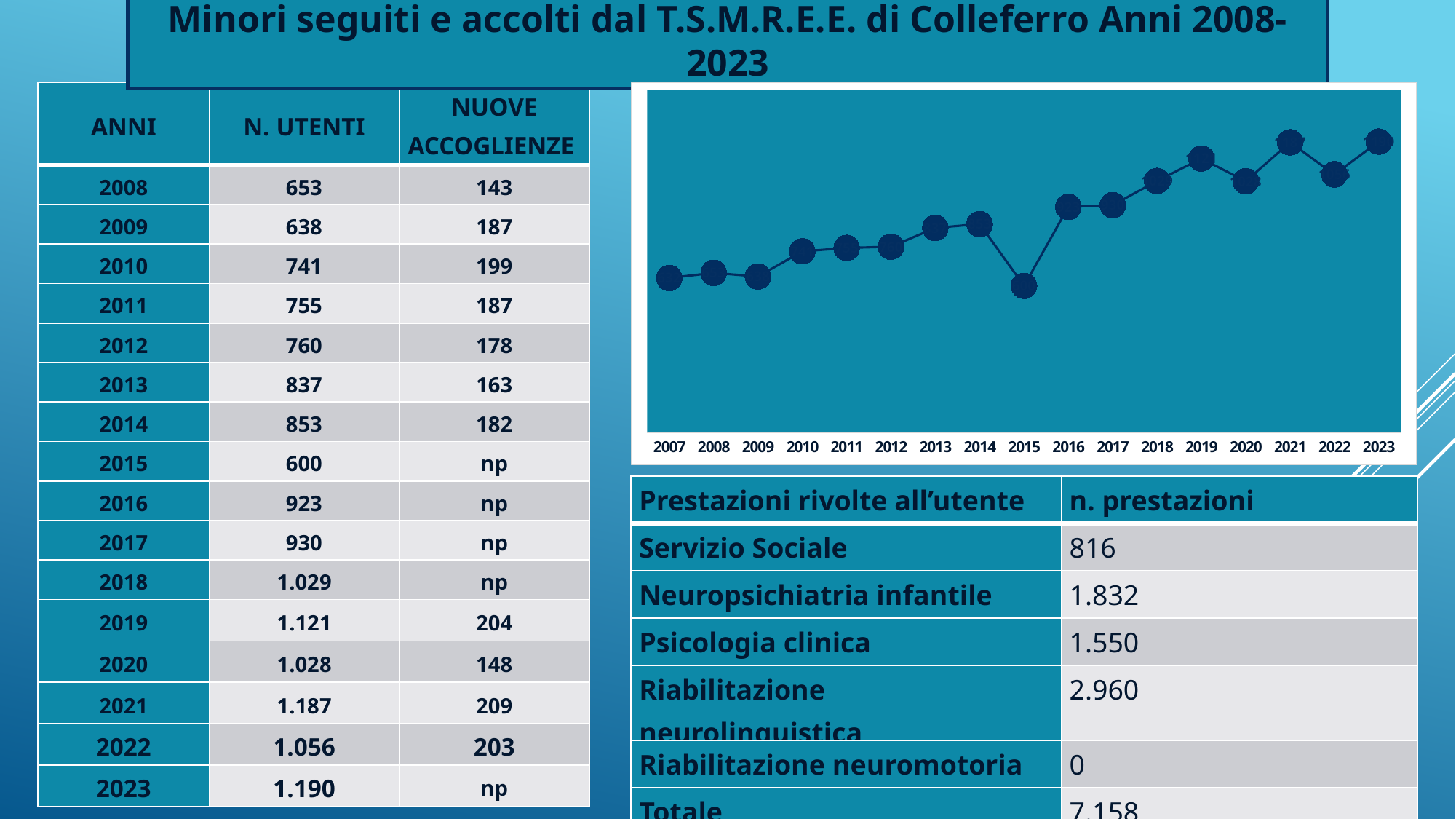
What kind of chart is shown on the right side of the slide? line chart Overall, do the values on the line chart rise or fall from 2007 to 2023? rise On the line chart, is the value for 2016 higher or lower than the value for 2015? higher On the line chart, is the value for 2010 higher or lower than the value for 2009? higher What is the last year shown on the x axis of the line chart? 2023 What is the first year shown on the x axis of the line chart? 2007 On the line chart, is the value for 2020 higher or lower than the value for 2019? lower Which year has the lowest value on the line chart? 2015 How many data points are plotted on the line chart? 17 Between 2014 and 2015, does the line chart rise or fall? fall